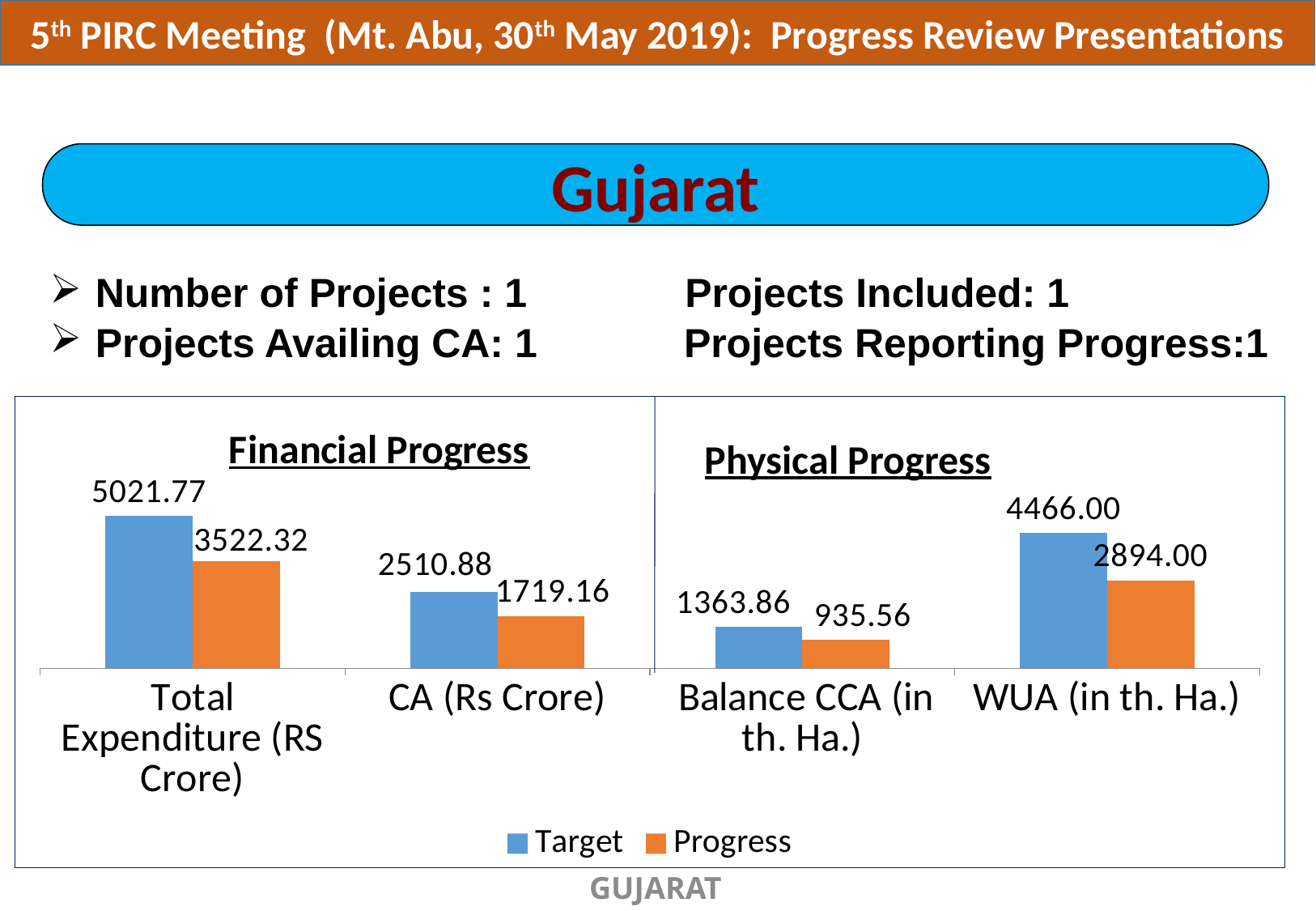
What kind of chart is shown on the slide? Bar chart What is the Progress value for CA (Rs Crore)? 1719.16 What is the difference between the Target and Progress values for WUA (in th. Ha.)? 1572.00 How many series does the chart legend list? 2 What is the Progress value for Balance CCA (in th. Ha.)? 935.56 What is the Target value for Total Expenditure (RS Crore)? 5021.77 Which category has the highest Target value? Total Expenditure (RS Crore) Which category has the lowest Progress value? Balance CCA (in th. Ha.) What is the Target value for WUA (in th. Ha.)? 4466.00 How many categories are shown on the x axis of the chart? 4 What is the difference between the Target and Progress values for Total Expenditure (RS Crore)? 1499.45 Which is larger: the Progress value for Total Expenditure (RS Crore) or the Target value for CA (Rs Crore)? Progress value for Total Expenditure (RS Crore)